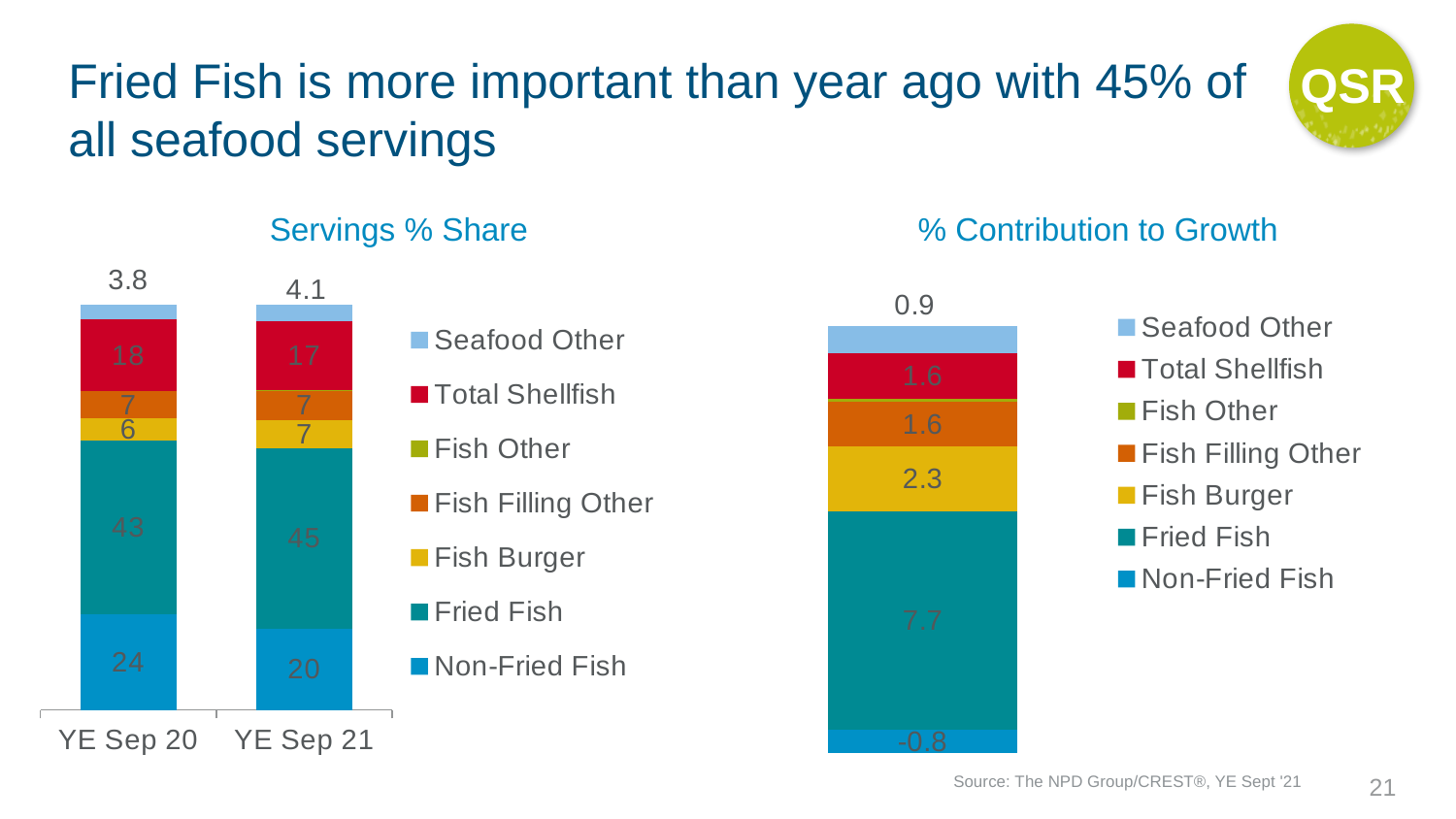
In the Servings % Share chart, which year has the larger Total Shellfish value, YE Sep 20 or YE Sep 21? YE Sep 20 In the % Contribution to Growth chart, what is the value for Fried Fish? 7.7 How many series does the legend of the Servings % Share chart list? 7 In the Servings % Share chart, does the Fried Fish value rise or fall from YE Sep 20 to YE Sep 21? rise How many categories are shown on the x axis of the Servings % Share chart? 2 In the % Contribution to Growth chart, what is the value for Non-Fried Fish? -0.8 In the Servings % Share chart, what is the difference in Non-Fried Fish between YE Sep 20 and YE Sep 21? 4 In the Servings % Share chart, what is the value for Non-Fried Fish in YE Sep 20? 24 In the Servings % Share chart, what is the value for Seafood Other in YE Sep 21? 4.1 What kind of chart is the % Contribution to Growth chart? stacked bar chart In the Servings % Share chart, by how much did the Fried Fish value change from YE Sep 20 to YE Sep 21? 2 In the Servings % Share chart, what is the value for Fried Fish in YE Sep 21? 45